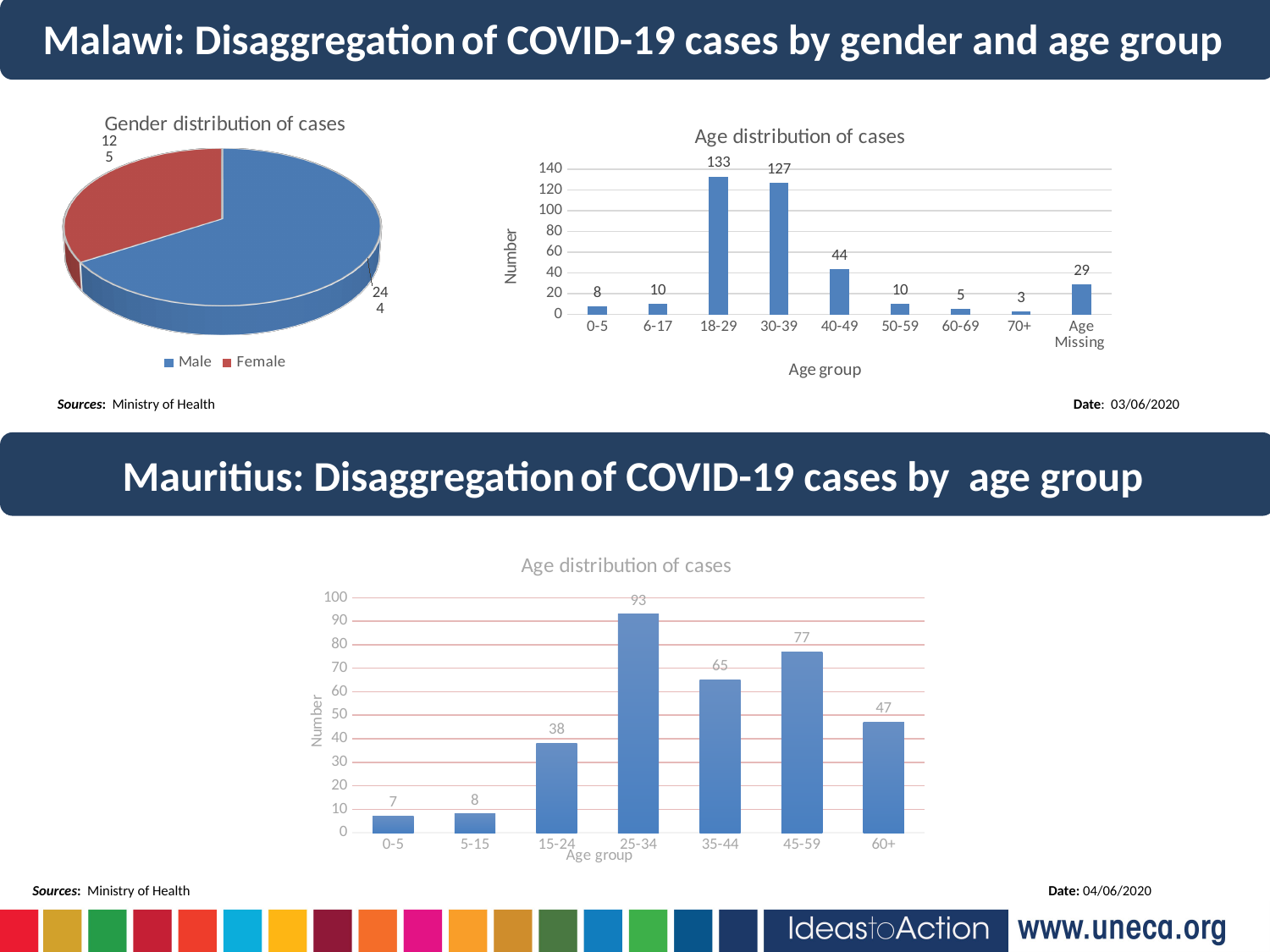
In the Mauritius 'Age distribution of cases' chart, what is the value for the 45-59 age group? 77 In the Mauritius 'Age distribution of cases' chart, how many age group categories are shown? 7 In the Malawi 'Age distribution of cases' chart, what is the value for the 18-29 age group? 133 What type of chart is the Malawi 'Gender distribution of cases' chart? Pie chart In the Mauritius 'Age distribution of cases' chart, what is the difference between the 25-34 and 35-44 age groups? 28 In the Malawi 'Age distribution of cases' chart, what is the difference between the 18-29 and 30-39 age groups? 6 In the Malawi 'Gender distribution of cases' chart, how many entries does the legend list? 2 In the Malawi 'Gender distribution of cases' pie chart, which slice is larger, Male or Female? Male In the Malawi 'Age distribution of cases' chart, what is the value for 'Age Missing'? 29 In the Mauritius 'Age distribution of cases' chart, which age group has the highest number of cases? 25-34 In the Malawi 'Age distribution of cases' chart, how many age group categories are shown on the x axis? 9 In the Malawi 'Age distribution of cases' chart, which age group has the lowest number of cases? 70+